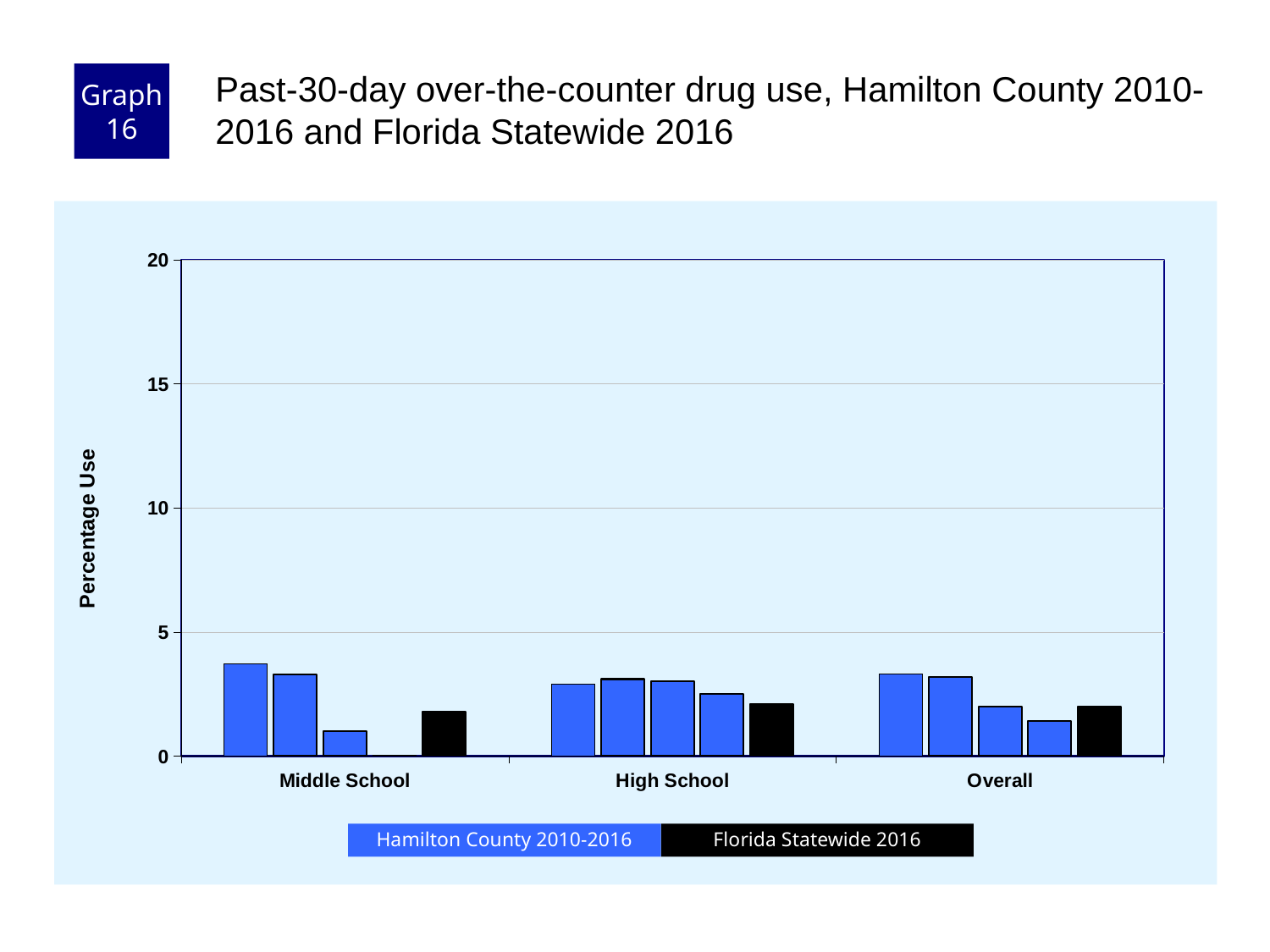
How many categories are shown on the x axis? 3 Is the Florida Statewide 2016 value for Middle School greater or less than 5? less Are any of the bars in the chart greater than 10? No How many series does the legend list? 2 What kind of chart is shown on the slide? bar chart Is the Florida Statewide 2016 value for Overall greater or less than 5? less What is the label of the y axis? Percentage Use Which category has the most Hamilton County 2010-2016 bars: Middle School or High School? High School Do the Hamilton County 2010-2016 bars for Overall rise or fall from left to right? fall What is the highest value shown on the y axis? 20